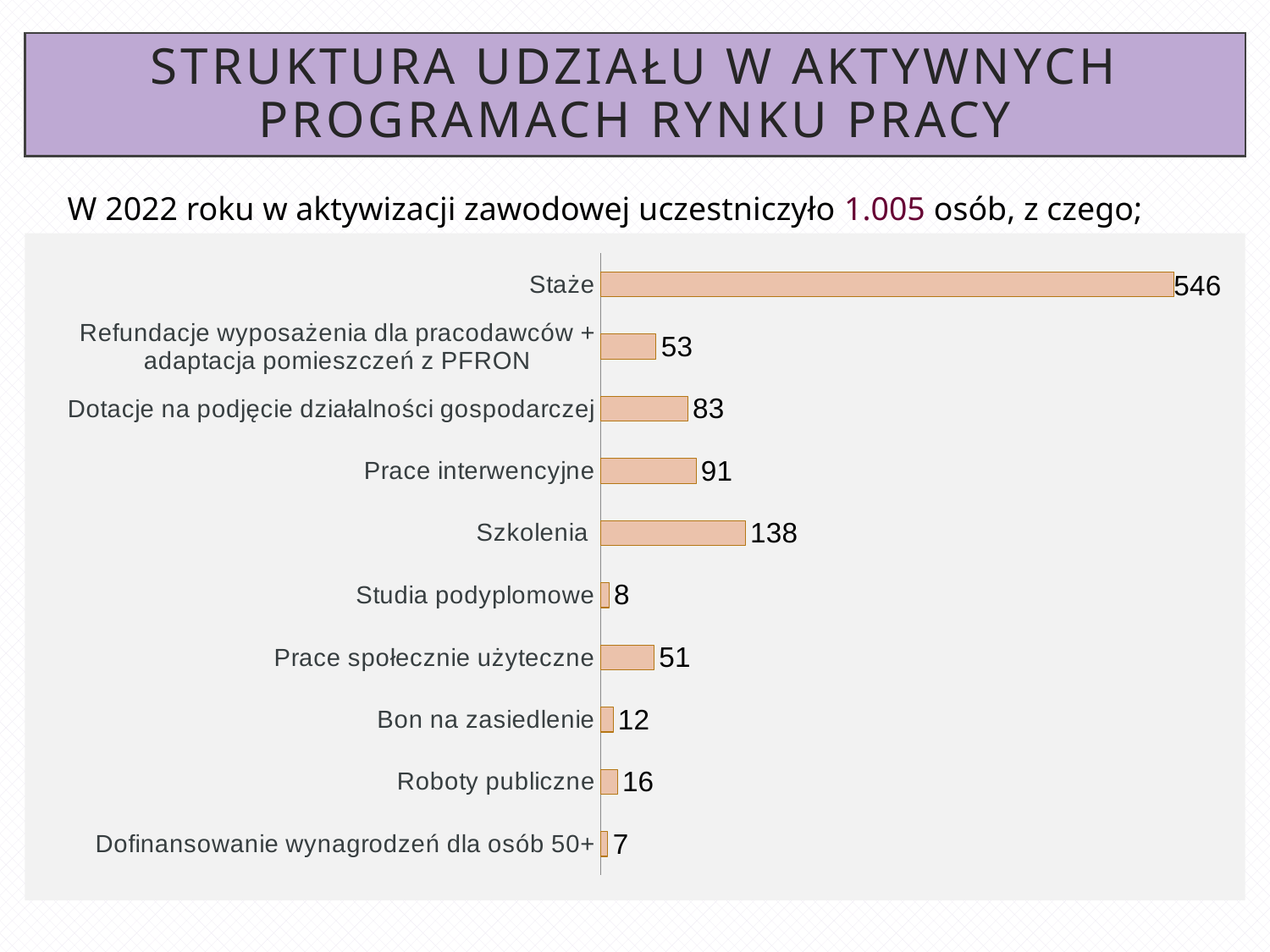
What is the difference between the values for Roboty publiczne and Studia podyplomowe? 8 Which category has the highest value? Staże What kind of chart is shown on the slide? bar chart What is the value for Prace interwencyjne? 91 What is the value for Staże? 546 Which category has the lowest value? Dofinansowanie wynagrodzeń dla osób 50+ Which is larger, the value for Dotacje na podjęcie działalności gospodarczej or the value for Prace społecznie użyteczne? Dotacje na podjęcie działalności gospodarczej What is the value for Szkolenia? 138 How many categories are shown in the chart? 10 What is the value for Bon na zasiedlenie? 12 What is the difference between the values for Szkolenia and Prace interwencyjne? 47 According to the text above the chart, how many people participated in professional activation in 2022? 1.005